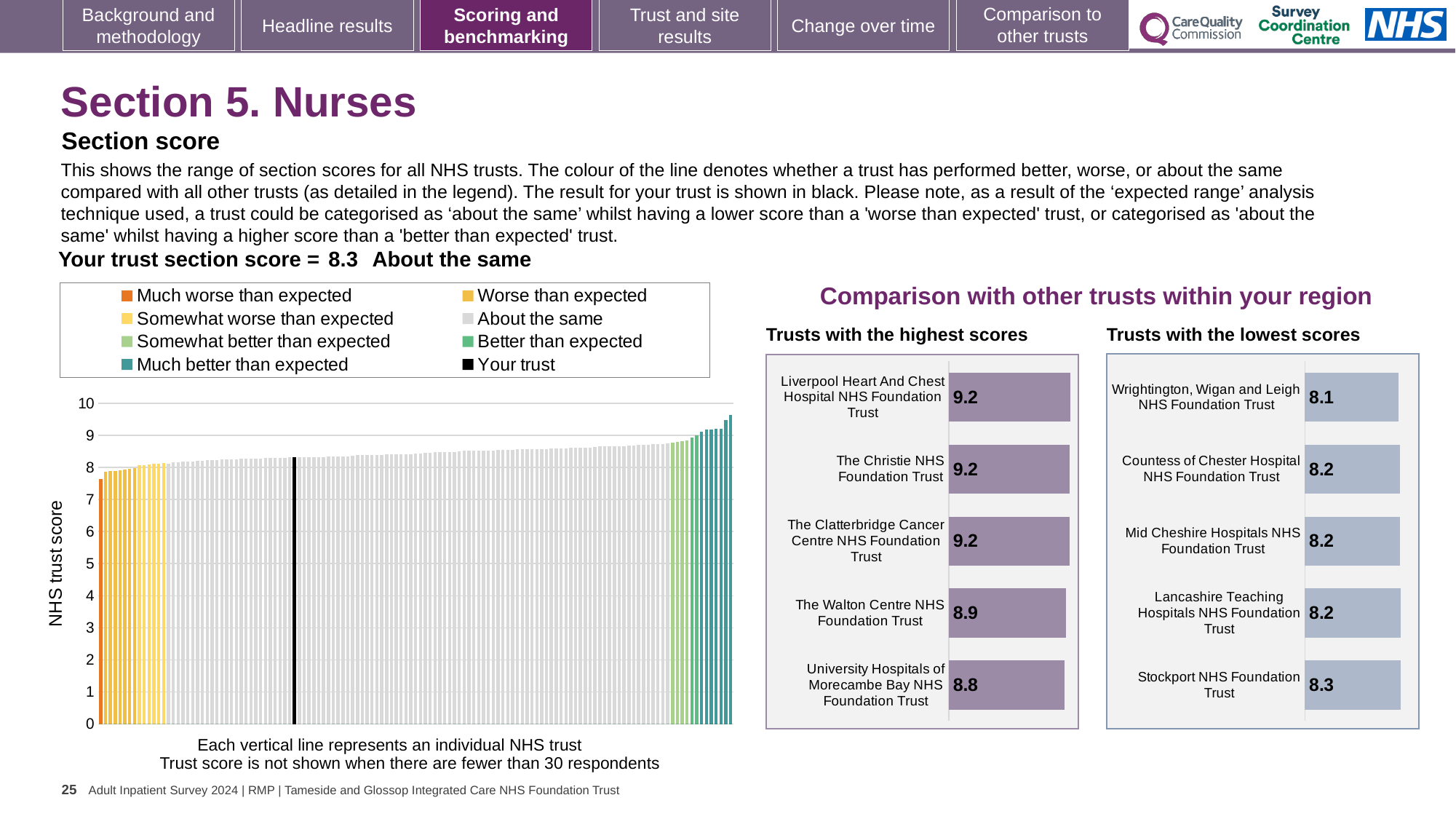
In the 'Trusts with the lowest scores' chart, what is the score for Wrightington, Wigan and Leigh NHS Foundation Trust? 8.1 In the large chart on the left showing all NHS trusts, do the trust scores rise or fall from left to right? rise In the 'Trusts with the highest scores' chart, what is the score for The Walton Centre NHS Foundation Trust? 8.9 In the 'Trusts with the highest scores' chart, which has the larger score: The Walton Centre NHS Foundation Trust or University Hospitals of Morecambe Bay NHS Foundation Trust? The Walton Centre NHS Foundation Trust In the 'Trusts with the highest scores' chart, what is the difference between the score for Liverpool Heart And Chest Hospital NHS Foundation Trust and the score for University Hospitals of Morecambe Bay NHS Foundation Trust? 0.4 In the 'Trusts with the lowest scores' chart, what is the difference between the score for Stockport NHS Foundation Trust and the score for Wrightington, Wigan and Leigh NHS Foundation Trust? 0.2 In the 'Trusts with the highest scores' chart, what is the score for University Hospitals of Morecambe Bay NHS Foundation Trust? 8.8 How many entries does the legend of the large chart on the left list? 8 How many trusts are shown in the 'Trusts with the lowest scores' chart? 5 In the 'Trusts with the highest scores' chart, which trust has the lowest score? University Hospitals of Morecambe Bay NHS Foundation Trust In the large chart on the left showing all NHS trusts, what is the section score for your trust (the black line)? 8.3 In the 'Trusts with the lowest scores' chart, which trust has the highest score? Stockport NHS Foundation Trust